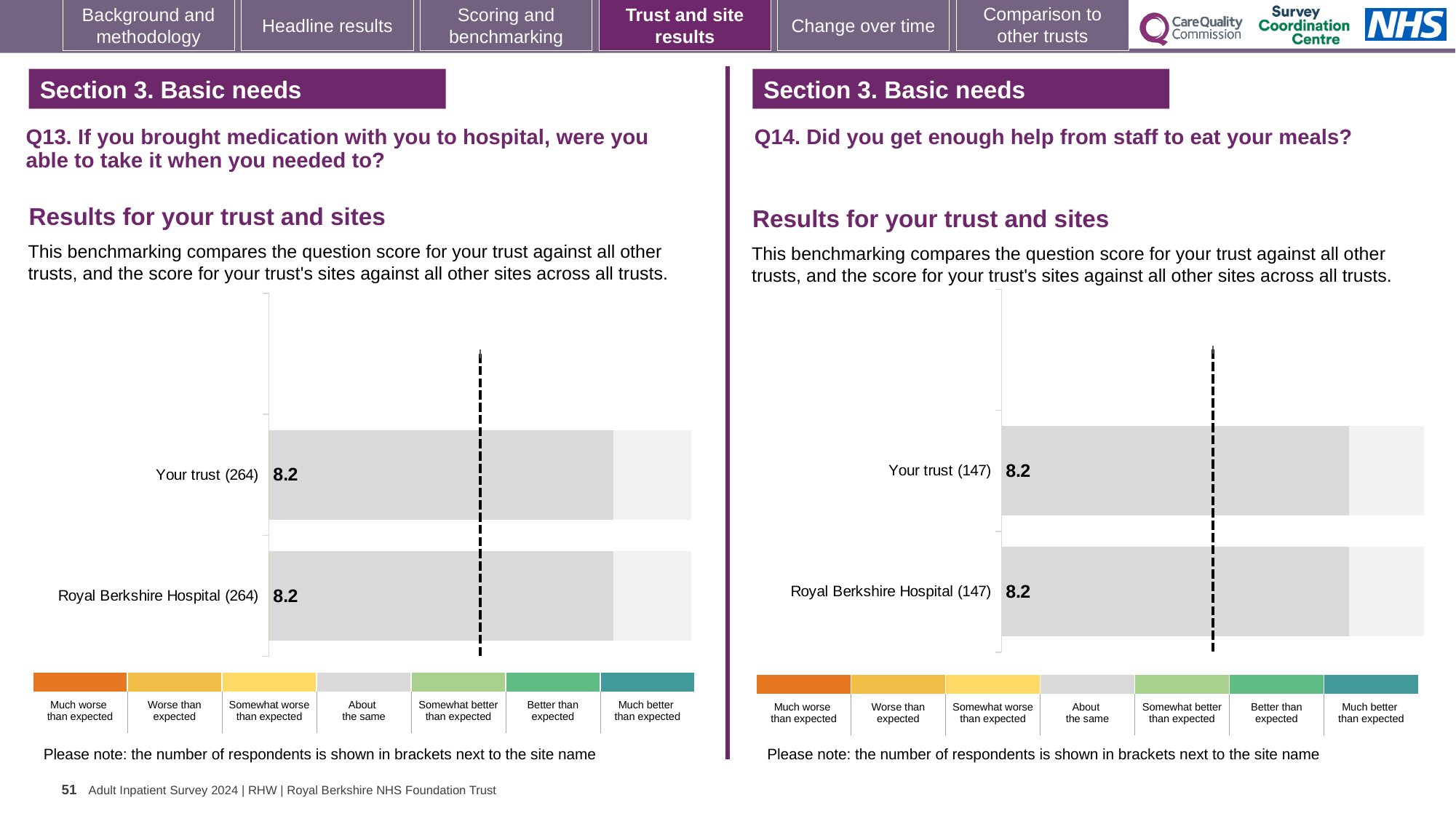
In the Q13 chart on the left, what is the score for Your trust? 8.2 In the Q14 chart on the right, how many respondents are shown in brackets next to Royal Berkshire Hospital? 147 In the Q13 chart on the left, how many bars are plotted? 2 In the Q13 chart on the left, what is the difference between the score for Your trust and the score for Royal Berkshire Hospital? 0.0 In the Q14 chart on the right, what is the score for Royal Berkshire Hospital? 8.2 In the Q14 chart on the right, how many bars are plotted? 2 In the Q14 chart on the right, what is the difference between the score for Your trust and the score for Royal Berkshire Hospital? 0.0 What kind of chart is the Q13 chart on the left? Bar chart In the Q13 chart on the left, how many respondents are shown in brackets next to Your trust? 264 In the Q13 chart on the left, what is the score for Royal Berkshire Hospital? 8.2 In the Q14 chart on the right, what is the score for Your trust? 8.2 In the Q13 chart on the left, is the score for Your trust greater or less than 5? greater